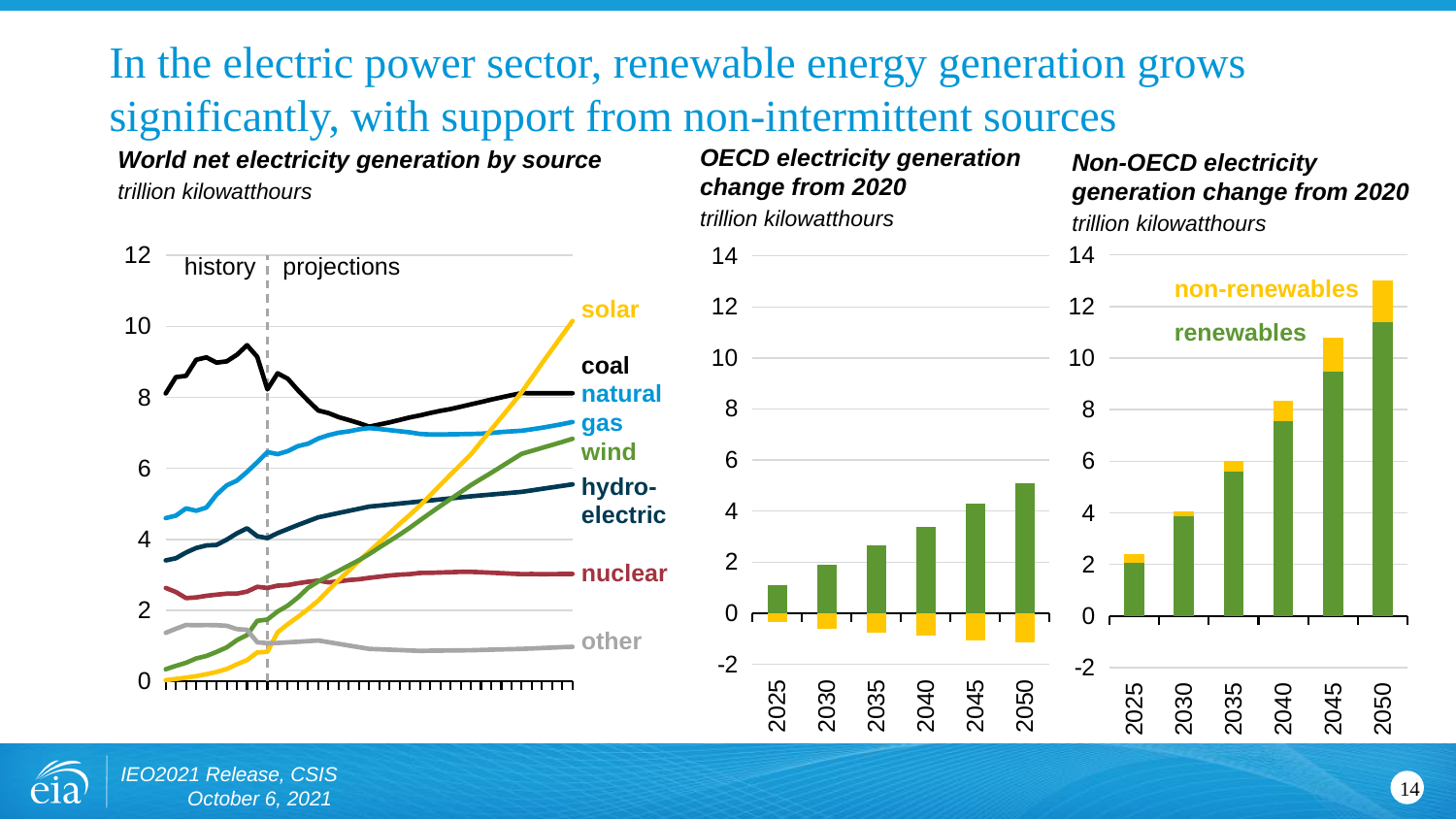
In the 'OECD electricity generation change from 2020' chart, is the renewables value for 2050 greater or less than 4? greater In the 'Non-OECD electricity generation change from 2020' chart, is the total stacked value for 2050 greater or less than 12? greater In the 'Non-OECD electricity generation change from 2020' chart, which colour represents renewables? green In the 'World net electricity generation by source' chart, which source has the lowest value at the end of the projection period? other What kind of chart is the 'World net electricity generation by source' chart? line chart In the 'World net electricity generation by source' chart, does the solar line rise or fall over the projection period? rise In the 'World net electricity generation by source' chart, is the value for solar at the end of the projections greater or less than 10? greater In the 'World net electricity generation by source' chart, at the end of the projections, which is larger: coal or nuclear? coal In the 'World net electricity generation by source' chart, which source has the highest value at the end of the projection period? solar In the 'World net electricity generation by source' chart, how many sources (series) are labelled? 7 In the 'OECD electricity generation change from 2020' chart, how many years are shown on the x axis? 6 What kind of chart is the 'OECD electricity generation change from 2020' chart? bar chart